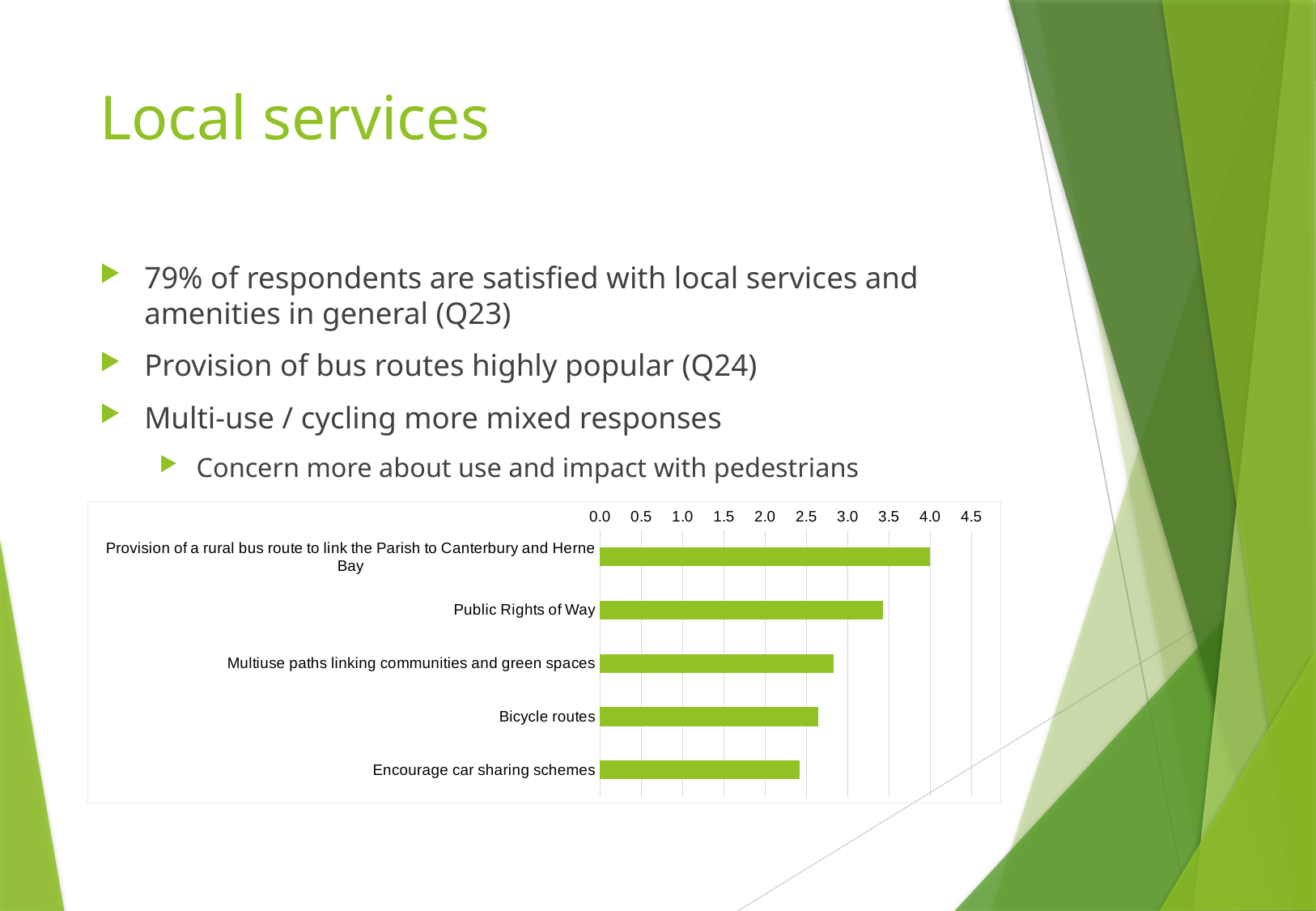
Is the value for Provision of a rural bus route to link the Parish to Canterbury and Herne Bay greater or less than 3.5? greater Which category has the lowest value in the chart? Encourage car sharing schemes How many categories are plotted in the chart? 5 Is the value for Multiuse paths linking communities and green spaces greater or less than 3.0? less What is the highest tick value shown on the chart's value axis? 4.5 Do the bar values increase or decrease going from the top category to the bottom category? decrease Which category has the highest value in the chart? Provision of a rural bus route to link the Parish to Canterbury and Herne Bay What kind of chart is shown on the slide? bar chart Which has the larger value: Public Rights of Way or Bicycle routes? Public Rights of Way Is the value for Encourage car sharing schemes greater or less than 2.0? greater Which has the larger value: Encourage car sharing schemes or Provision of a rural bus route to link the Parish to Canterbury and Herne Bay? Provision of a rural bus route to link the Parish to Canterbury and Herne Bay